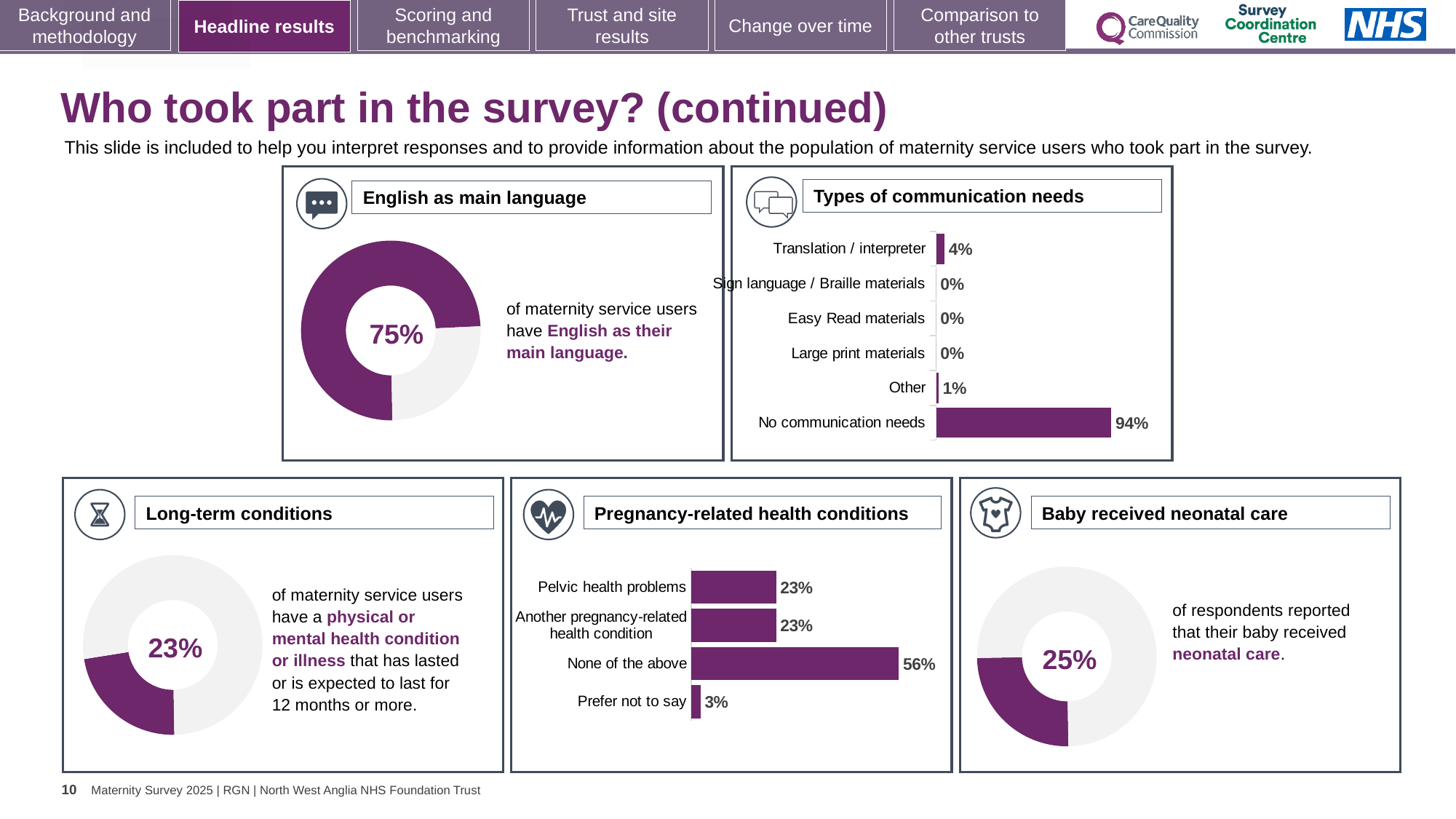
In the 'English as main language' donut chart, what percentage of maternity service users have English as their main language? 75% In the 'Types of communication needs' chart, what is the difference between 'No communication needs' and 'Translation / interpreter'? 90% In the 'Pregnancy-related health conditions' chart, what is the value for 'None of the above'? 56% In the 'Baby received neonatal care' donut chart, what percentage of respondents reported that their baby received neonatal care? 25% In the 'Pregnancy-related health conditions' chart, which category has the lowest value? Prefer not to say In the 'Pregnancy-related health conditions' chart, what is the difference between 'None of the above' and 'Pelvic health problems'? 33% In the 'Types of communication needs' chart, how many categories are shown? 6 What kind of chart is the 'Pregnancy-related health conditions' chart? Bar chart In the 'Types of communication needs' chart, what is the value for 'No communication needs'? 94% In the 'Types of communication needs' chart, which category has the highest value? No communication needs In the 'Long-term conditions' donut chart, what percentage of maternity service users have a physical or mental health condition or illness? 23% In the 'Types of communication needs' chart, what is the value for 'Translation / interpreter'? 4%